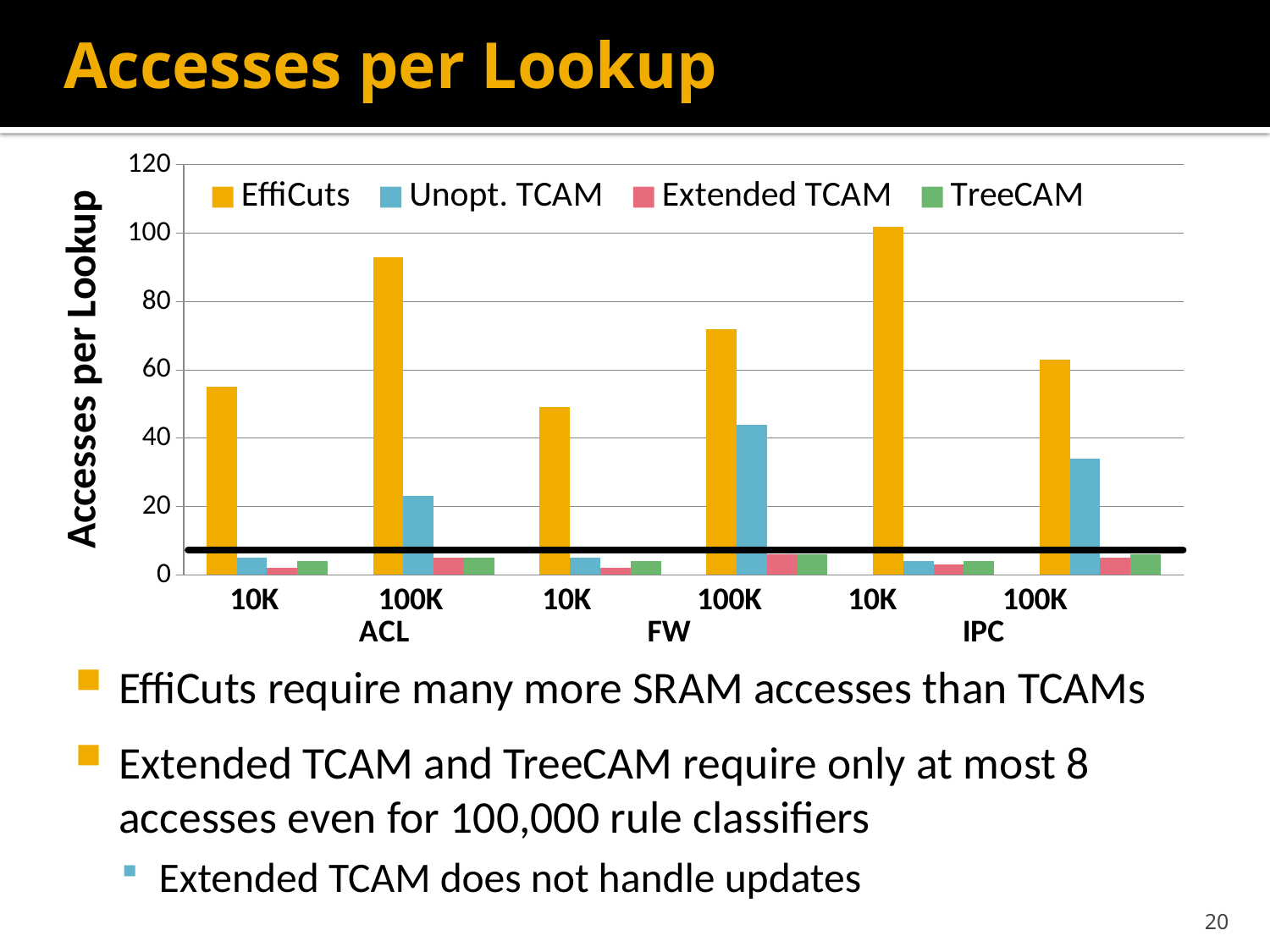
Is the EffiCuts value for IPC 10K greater or less than 80? greater Is the Unopt. TCAM value for ACL 100K greater or less than 40? less Is the EffiCuts value for ACL 100K greater or less than 80? greater What is the label of the y axis? Accesses per Lookup For which category is the EffiCuts value highest? IPC 10K Which is larger, the Unopt. TCAM value for FW 100K or for IPC 100K? FW 100K What kind of chart is shown on the slide? bar chart For which category is the Unopt. TCAM value highest? FW 100K How many category groups (classifier sizes) are shown along the x axis? 6 Which is larger, the EffiCuts value for ACL 100K or for FW 100K? ACL 100K How many series does the legend list? 4